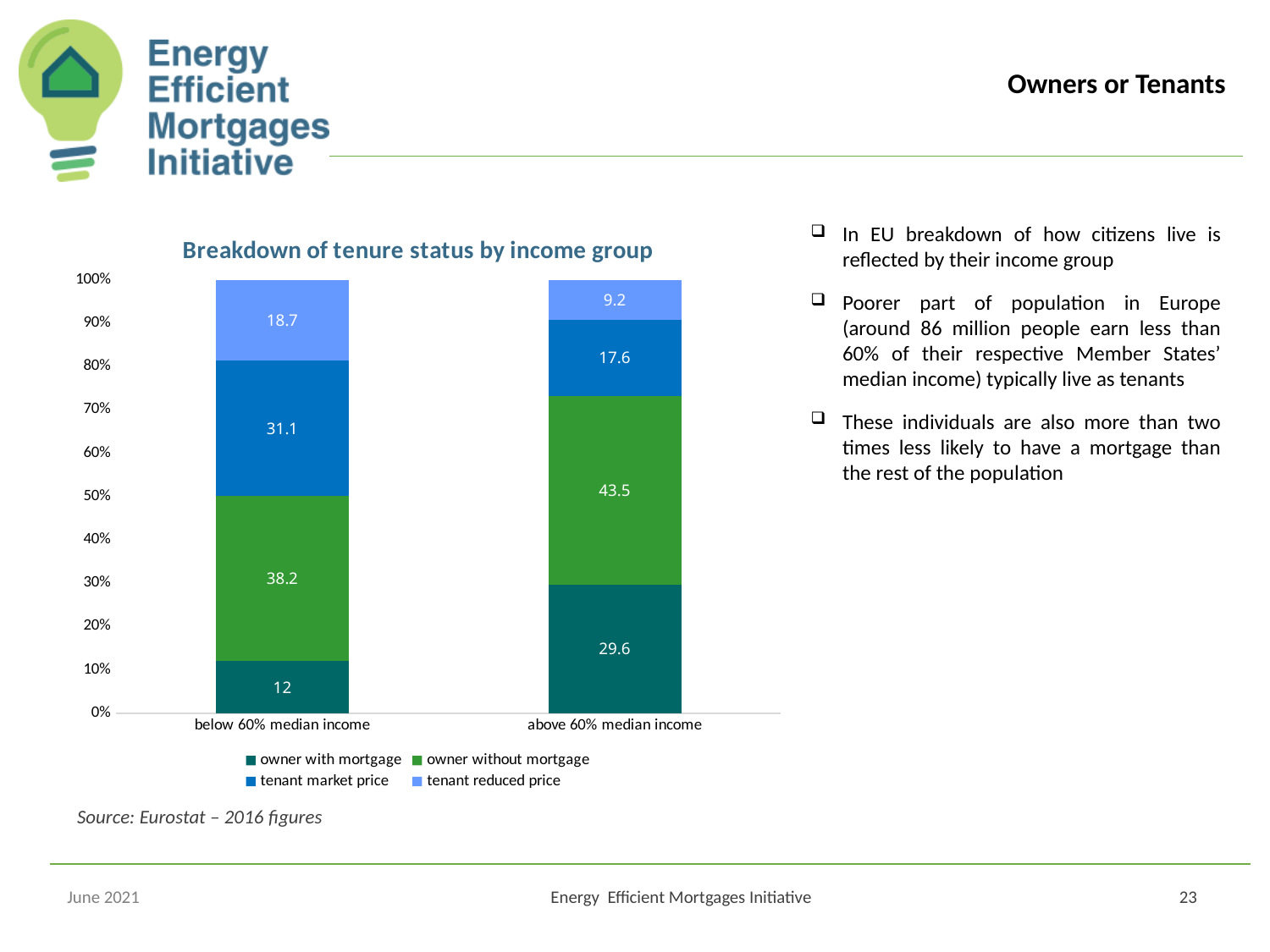
What is the value for 'owner without mortgage' in the 'above 60% median income' group? 43.5 What is the difference between the 'tenant market price' values for the 'below 60% median income' and 'above 60% median income' groups? 13.5 What is the value for 'tenant market price' in the 'above 60% median income' group? 17.6 Which series has the smallest value in the 'below 60% median income' bar? owner with mortgage What kind of chart is shown on the slide? stacked bar chart Which series has the largest value in the 'above 60% median income' bar? owner without mortgage What is the difference between the 'owner with mortgage' values for the 'above 60% median income' and 'below 60% median income' groups? 17.6 Which group has the larger 'tenant reduced price' value, 'below 60% median income' or 'above 60% median income'? below 60% median income How many series does the legend list? 4 What is the value for 'owner with mortgage' in the 'below 60% median income' group? 12 What is the value for 'tenant reduced price' in the 'below 60% median income' group? 18.7 What is the title of the chart? Breakdown of tenure status by income group